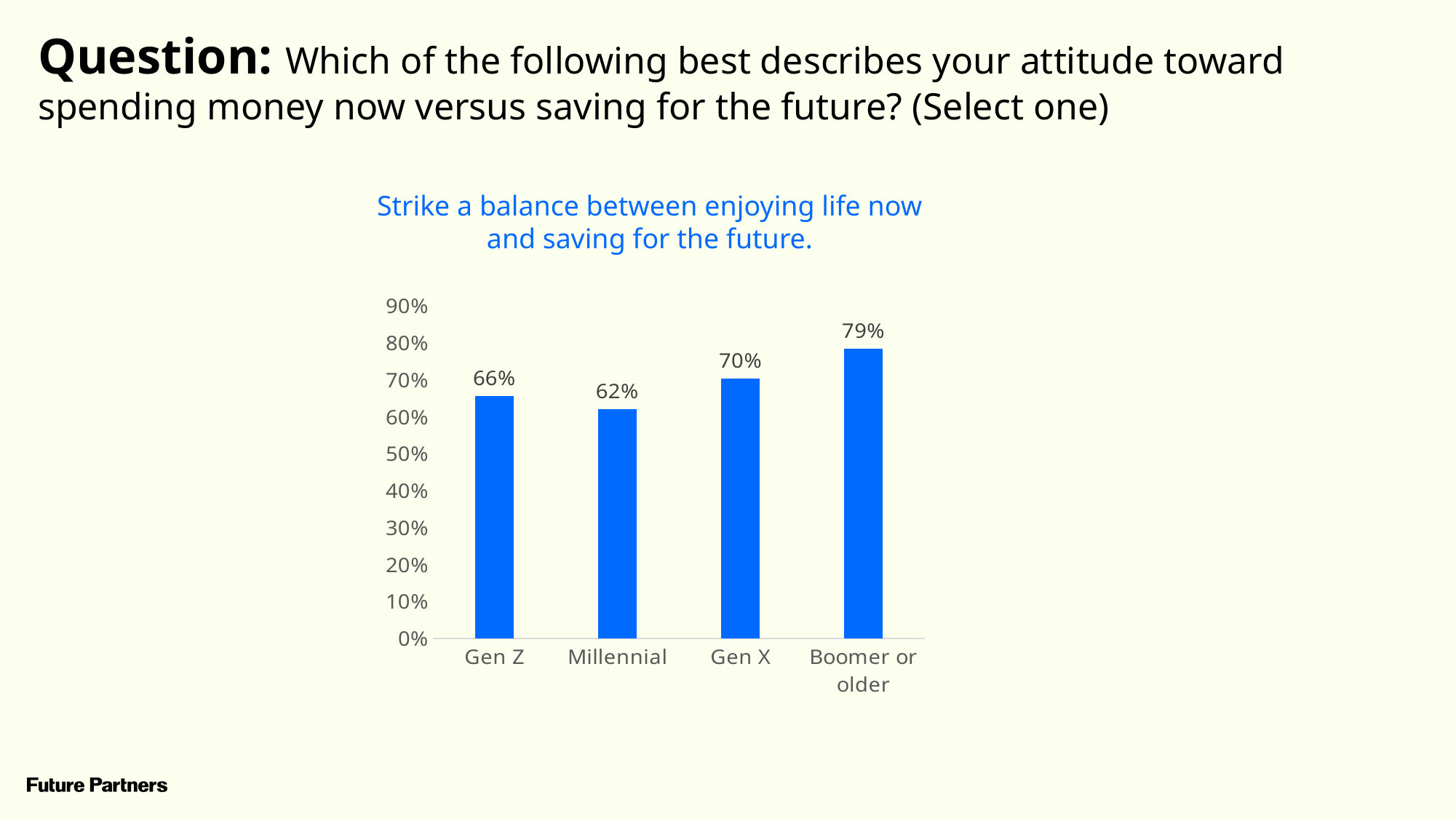
What is the difference between the values for Gen X and Gen Z? 4% What kind of chart is shown on the slide? Bar chart What percentage of Gen Z respondents said they strike a balance between enjoying life now and saving for the future? 66% Which is larger, the value for Gen Z or the value for Millennial? Gen Z What is the value shown for Millennial? 62% What is the value shown for Boomer or older? 79% What is the difference between the values for Boomer or older and Millennial? 17% What is the title of the chart? Strike a balance between enjoying life now and saving for the future. Which generation has the highest value? Boomer or older What is the value shown for Gen X? 70% Which generation has the lowest value? Millennial How many generation categories are shown on the chart? 4